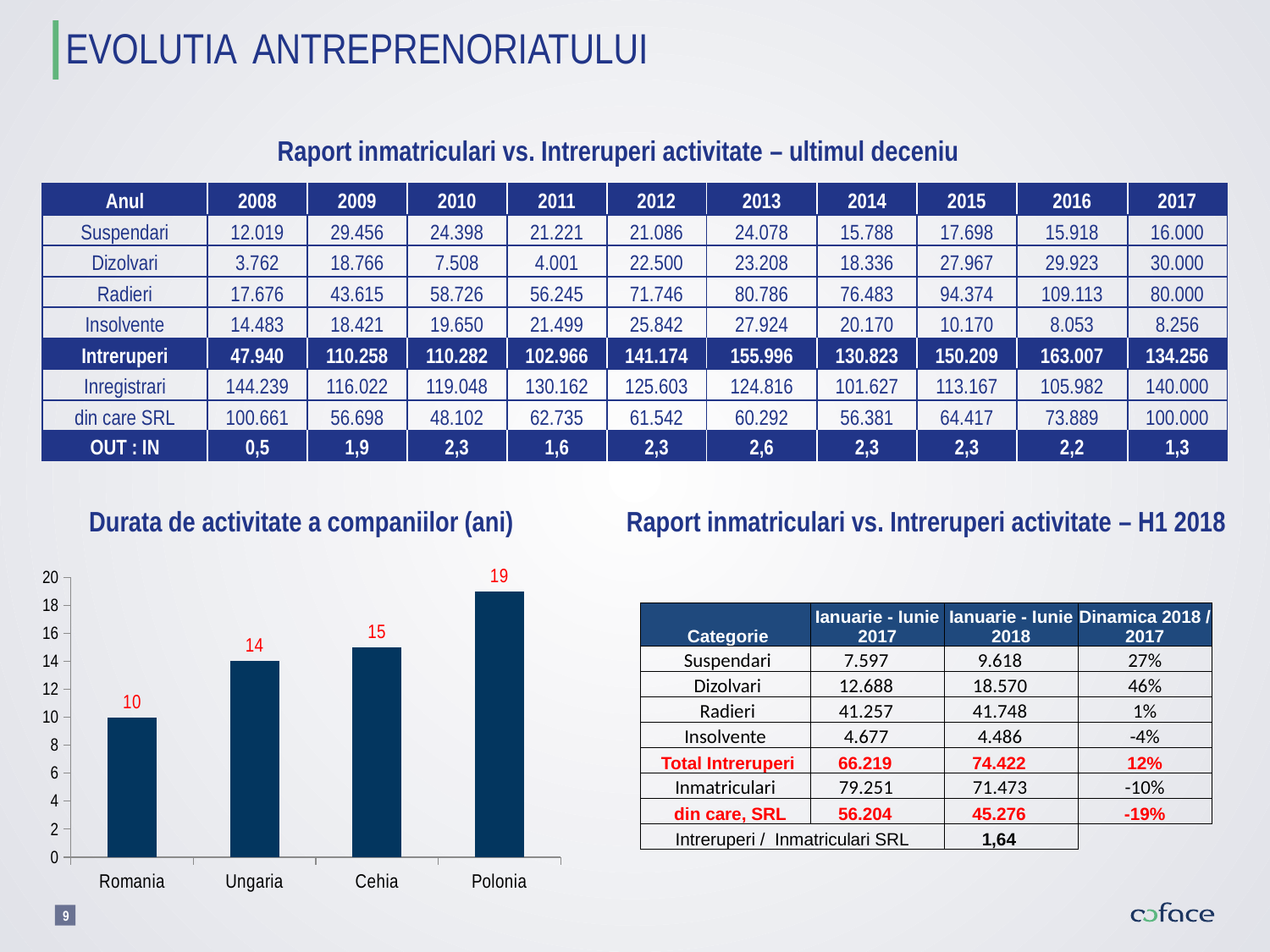
Which country has the lowest value in the 'Durata de activitate a companiilor (ani)' chart? Romania What is the value for Cehia in the 'Durata de activitate a companiilor (ani)' chart? 15 In the 'Durata de activitate a companiilor (ani)' chart, what is the difference between the values for Polonia and Romania? 9 Which country has the highest value in the 'Durata de activitate a companiilor (ani)' chart? Polonia In the 'Durata de activitate a companiilor (ani)' chart, do the values rise or fall from Romania to Polonia? rise How many countries are shown in the 'Durata de activitate a companiilor (ani)' chart? 4 What kind of chart is 'Durata de activitate a companiilor (ani)'? bar chart What is the value for Ungaria in the 'Durata de activitate a companiilor (ani)' chart? 14 In the 'Durata de activitate a companiilor (ani)' chart, which is larger, the value for Ungaria or the value for Cehia? Cehia In the 'Durata de activitate a companiilor (ani)' chart, is the value for Polonia greater or less than 16? greater What is the value for Polonia in the 'Durata de activitate a companiilor (ani)' chart? 19 What is the value for Romania in the 'Durata de activitate a companiilor (ani)' chart? 10